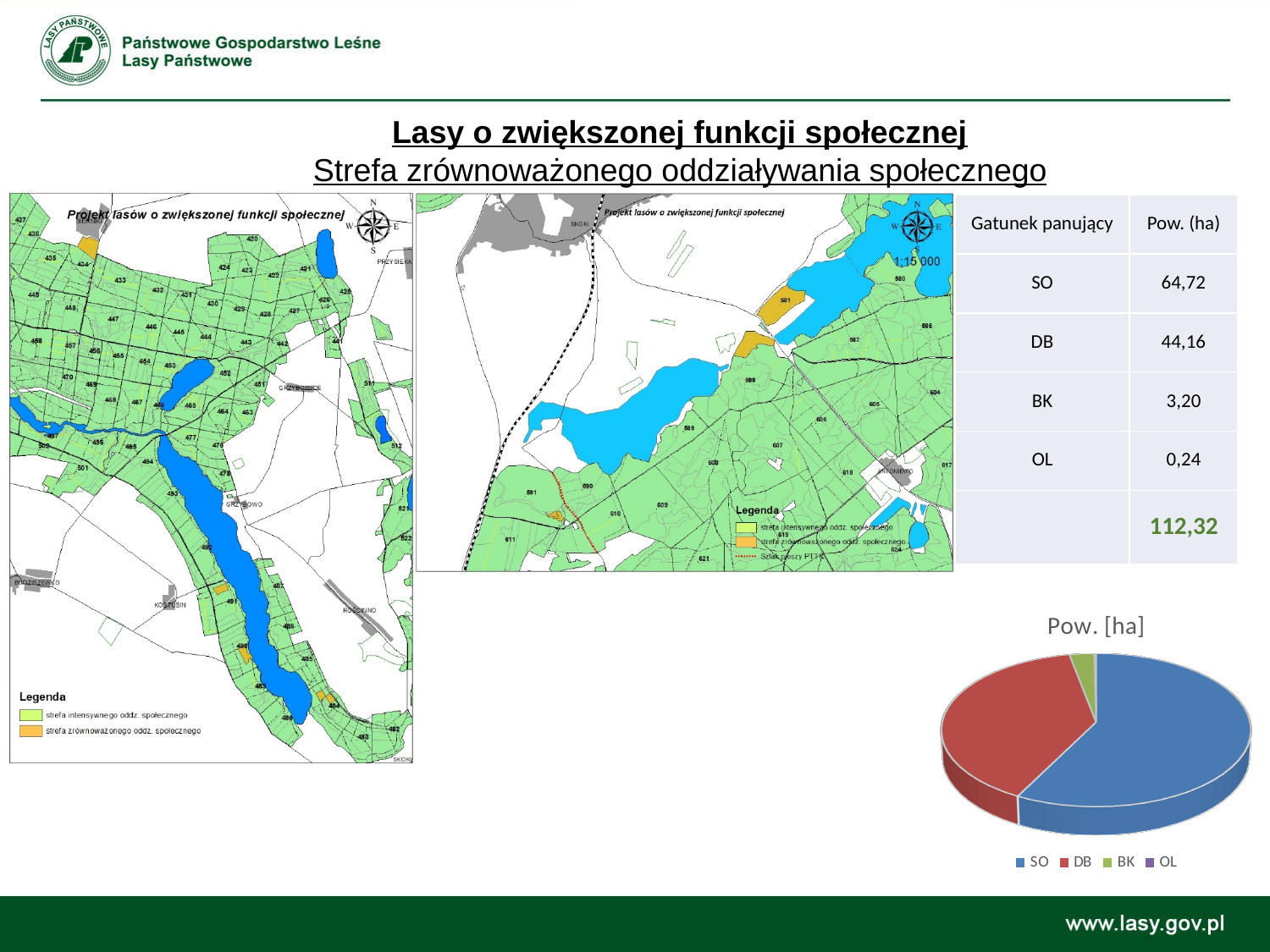
According to the table next to the pie chart, what is the area (Pow. (ha)) for DB? 44,16 Which category has the smallest slice in the "Pow. [ha]" pie chart? OL What is the title of the pie chart? Pow. [ha] What kind of chart is shown at the bottom right of the slide? pie chart In the "Pow. [ha]" pie chart, which slice is larger, SO or DB? SO According to the table next to the pie chart, what is the area (Pow. (ha)) for BK? 3,20 In the "Pow. [ha]" pie chart, which slice is larger, DB or BK? DB How many categories does the legend of the "Pow. [ha]" pie chart list? 4 What colour is the SO slice in the pie chart? blue According to the table next to the pie chart, what is the area (Pow. (ha)) for SO? 64,72 What is the total area (ha) shown in the table for all species in the pie chart? 112,32 Which category has the largest slice in the "Pow. [ha]" pie chart? SO